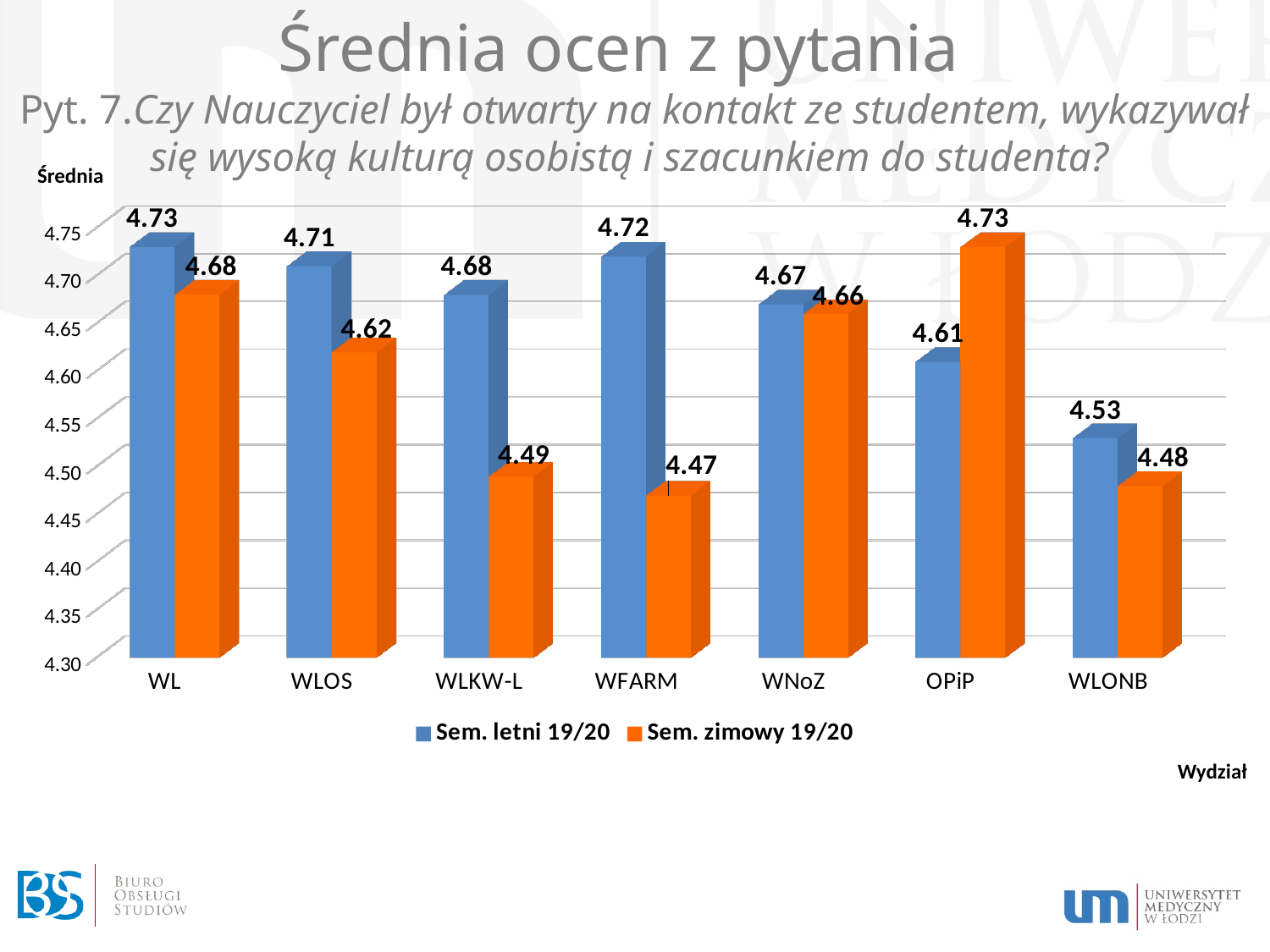
What is the value for WLKW-L in the Sem. zimowy 19/20 series? 4.49 What is the value for OPiP in the Sem. zimowy 19/20 series? 4.73 What is the difference between the Sem. letni 19/20 and Sem. zimowy 19/20 values for WFARM? 0.25 Which is larger for OPiP: the Sem. letni 19/20 value or the Sem. zimowy 19/20 value? Sem. zimowy 19/20 What is the value for WFARM in the Sem. letni 19/20 series? 4.72 Which category has the highest value in the Sem. zimowy 19/20 series? OPiP Which category has the lowest value in the Sem. letni 19/20 series? WLONB Is the Sem. zimowy 19/20 value for WLONB greater or less than 4.50? less Which category has the lowest value in the Sem. zimowy 19/20 series? WFARM How many series does the legend list? 2 How many categories (wydziały) are shown on the x axis? 7 What kind of chart is shown on the slide? bar chart